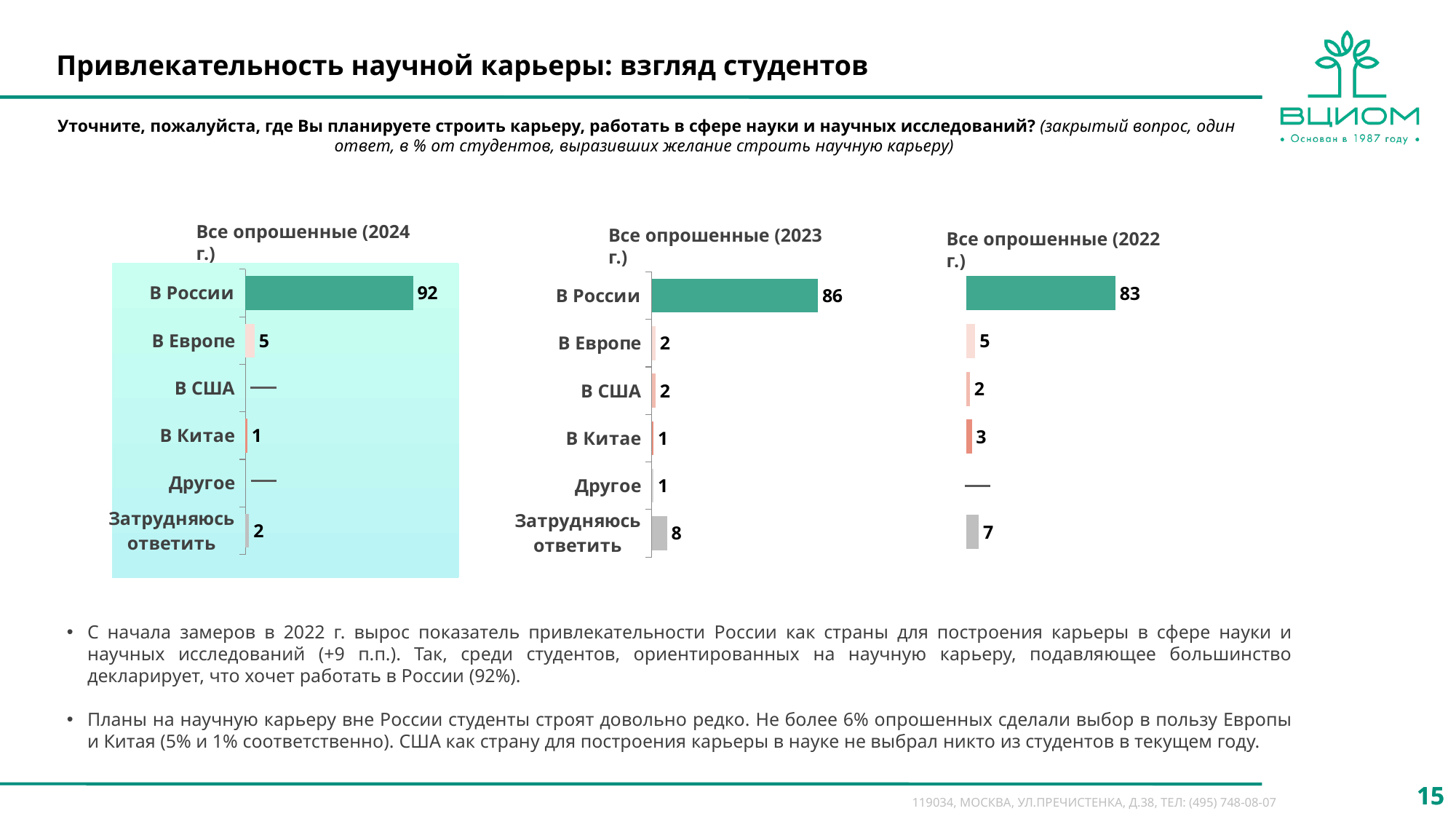
In the chart 'Все опрошенные (2024 г.)', what is the value for 'В России'? 92 How many categories are listed in the chart 'Все опрошенные (2024 г.)'? 6 Which is larger: the 'В Европе' value in the 2024 chart or the 'В Европе' value in the 2023 chart? 2024 chart In the chart 'Все опрошенные (2023 г.)', what is the difference between 'Затрудняюсь ответить' and 'В Европе'? 6 What is the difference between the 'В России' value in the 2024 chart and the 'В России' value in the 2023 chart? 6 In the chart 'Все опрошенные (2023 г.)', which category has the highest value? В России What is the value of the top bar in the chart 'Все опрошенные (2022 г.)'? 83 What type of chart is 'Все опрошенные (2023 г.)'? Bar chart In the chart 'Все опрошенные (2024 г.)', which category has the lowest value among those with a printed number? В Китае In the chart 'Все опрошенные (2023 г.)', what is the value for 'Затрудняюсь ответить'? 8 In the chart 'Все опрошенные (2024 г.)', what is the value for 'В Европе'? 5 How many charts are shown on the slide? 3